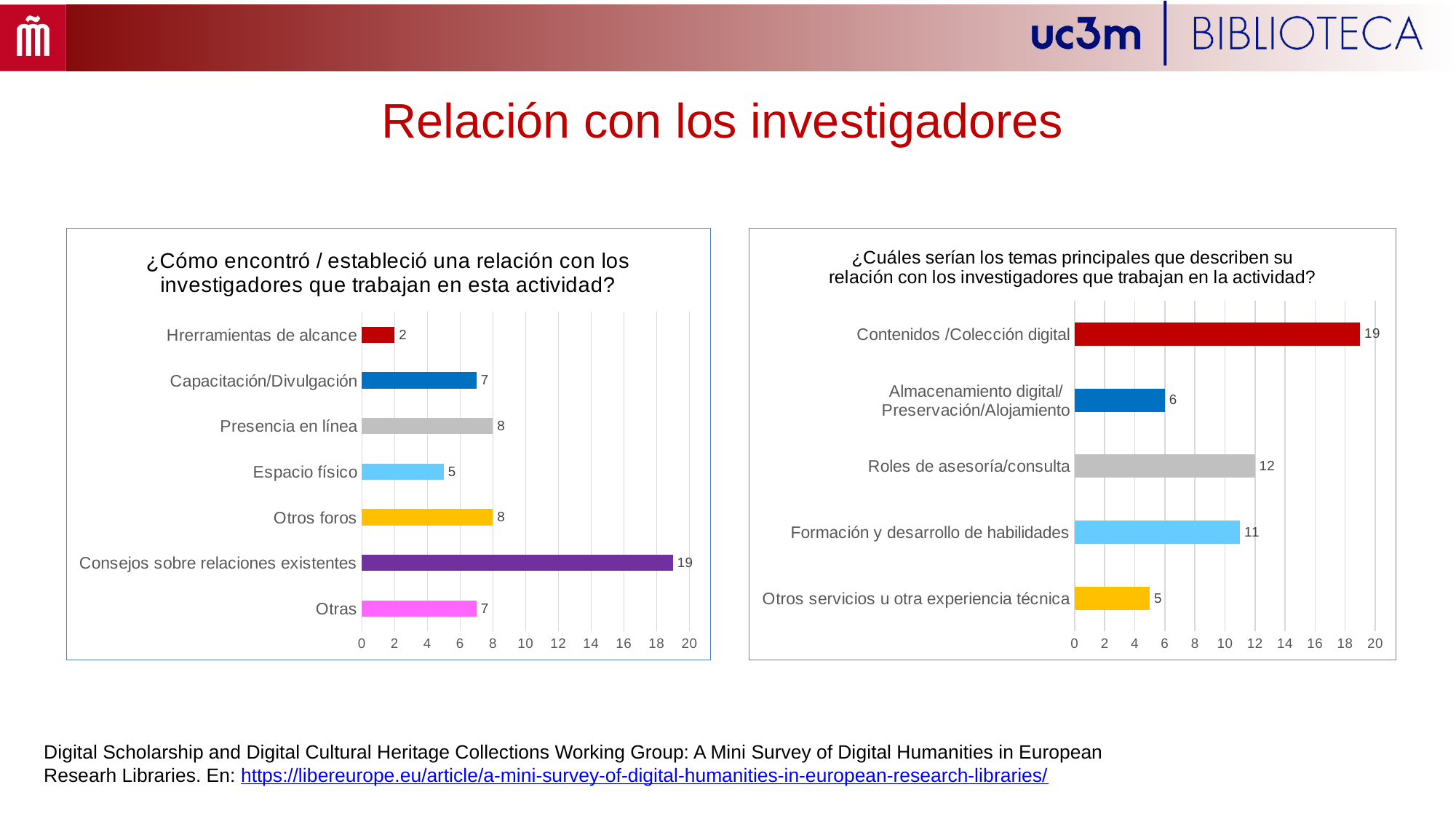
In the left chart, which category has the highest value? Consejos sobre relaciones existentes In the right chart, which category has the highest value? Contenidos /Colección digital In the left chart, how many categories are shown? 7 In the left chart, what is the difference between Consejos sobre relaciones existentes and Espacio físico? 14 In the right chart (¿Cuáles serían los temas principales...?), what is the value for Roles de asesoría/consulta? 12 In the left chart, which is larger: Capacitación/Divulgación or Otros foros? Otros foros In the right chart, which category has the lowest value? Otros servicios u otra experiencia técnica In the left chart (¿Cómo encontró / estableció una relación con los investigadores...?), what is the value for Presencia en línea? 8 What type of chart is the right chart? Bar chart In the left chart, which category has the lowest value? Hrerramientas de alcance In the right chart, what is the difference between Contenidos /Colección digital and Formación y desarrollo de habilidades? 8 In the right chart, how many categories are shown? 5